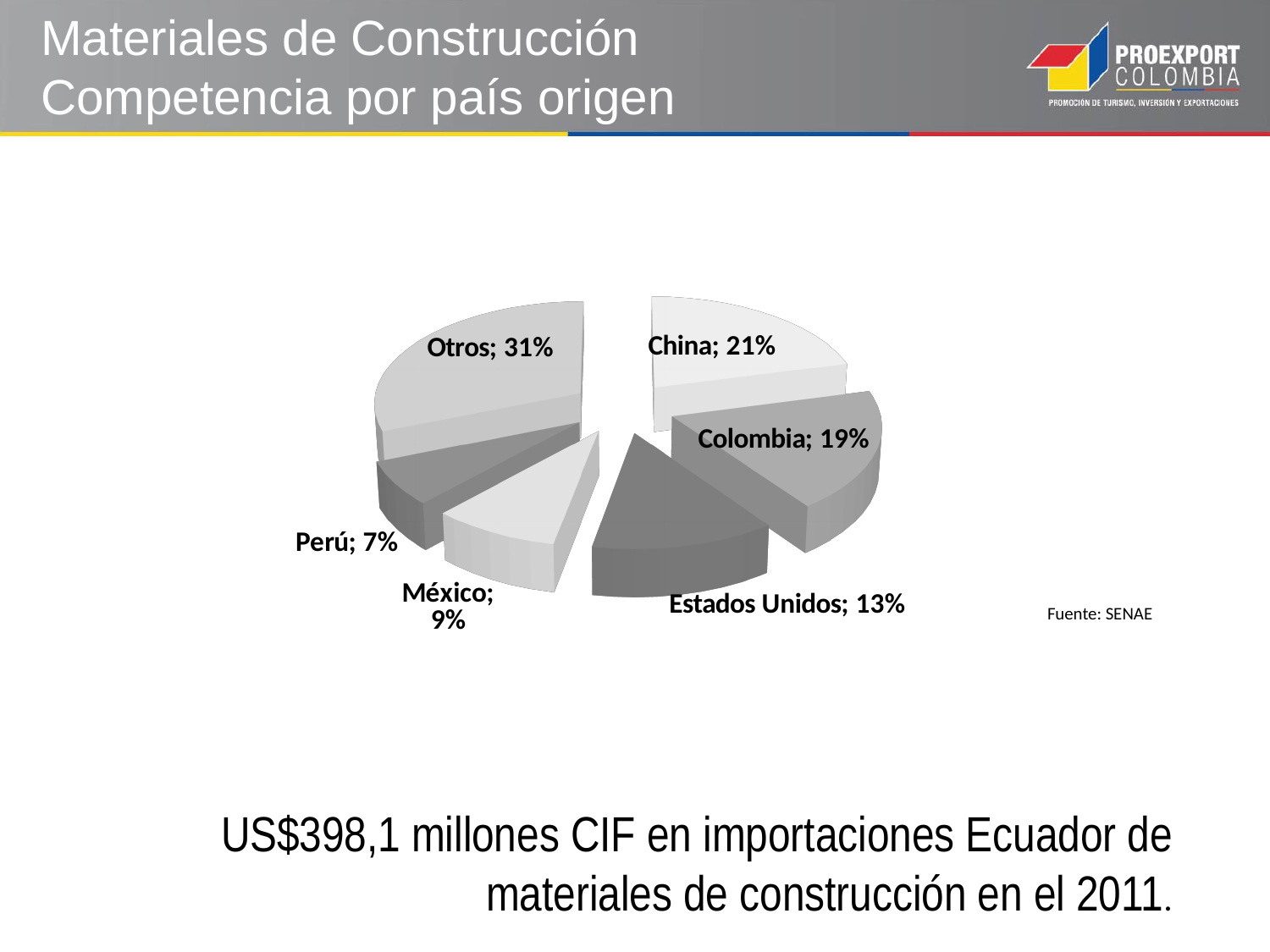
What is the difference in percentage points between China and Colombia? 2 Which slice of the pie is the largest? Otros What kind of chart is shown on the slide? Pie chart What is the value shown for Estados Unidos? 13% Which slice of the pie is the smallest? Perú What share of the pie does China hold? 21% How many slices does the pie chart have? 6 Which is larger, the share for Estados Unidos or the share for México? Estados Unidos What is the value shown for México? 9% What is the value shown for Perú? 7% What share of the pie does Colombia hold? 19% What source is cited for the chart? SENAE